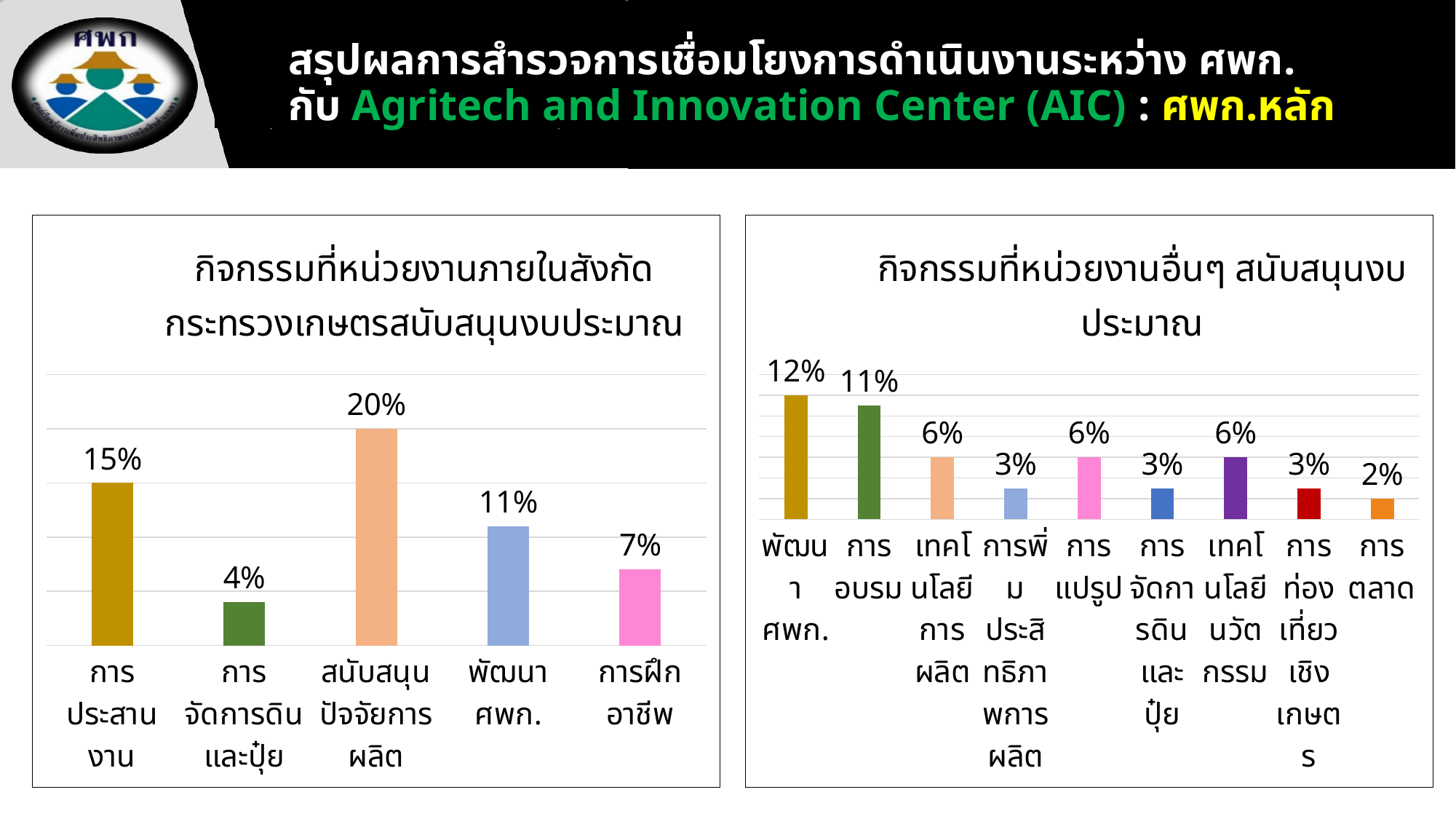
In the right chart, what is the difference between พัฒนาศพก. and การอบรม? 1% In the left chart, how many categories are shown? 5 What is the title of the right chart? กิจกรรมที่หน่วยงานอื่นๆ สนับสนุนงบประมาณ In the right chart, what is the value for การแปรรูป? 6% In the right chart, which category has the highest value? พัฒนาศพก. In the left chart, what is the difference between การประสานงาน and การฝึกอาชีพ? 8% In the left chart, which category has the lowest value? การจัดการดินและปุ๋ย In the right chart, how many categories are shown? 9 In the left chart, what is the value for สนับสนุนปัจจัยการผลิต? 20% What type of chart is the left chart? Bar chart In the left chart, which is larger: พัฒนาศพก. or การจัดการดินและปุ๋ย? พัฒนาศพก. In the right chart, what is the value for การตลาด? 2%